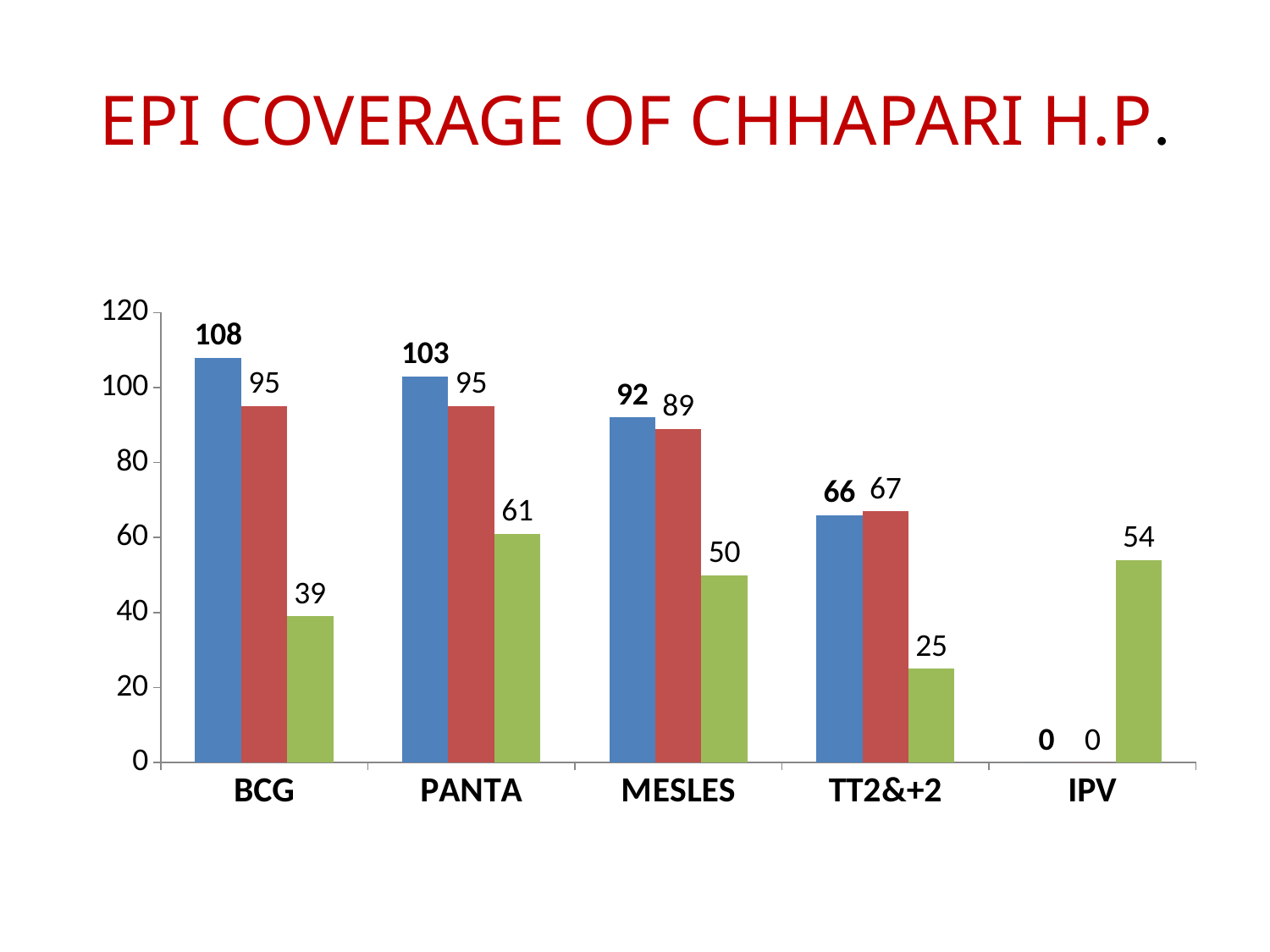
What is the difference between the blue bar and the green bar for BCG? 69 What is the value of the green bar for PANTA? 61 Do the blue bars rise or fall from BCG to IPV along the x axis? fall What is the value of the green bar for IPV? 54 How many categories are shown on the x axis? 5 For TT2&+2, which is larger, the blue bar or the red bar? the red bar Which category has the lowest green bar? TT2&+2 What is the title of the chart on the slide? EPI COVERAGE OF CHHAPARI H.P. What is the value of the red bar for MESLES? 89 What is the value of the blue bar for BCG? 108 What kind of chart is shown on the slide? bar chart Which category has the highest blue bar? BCG